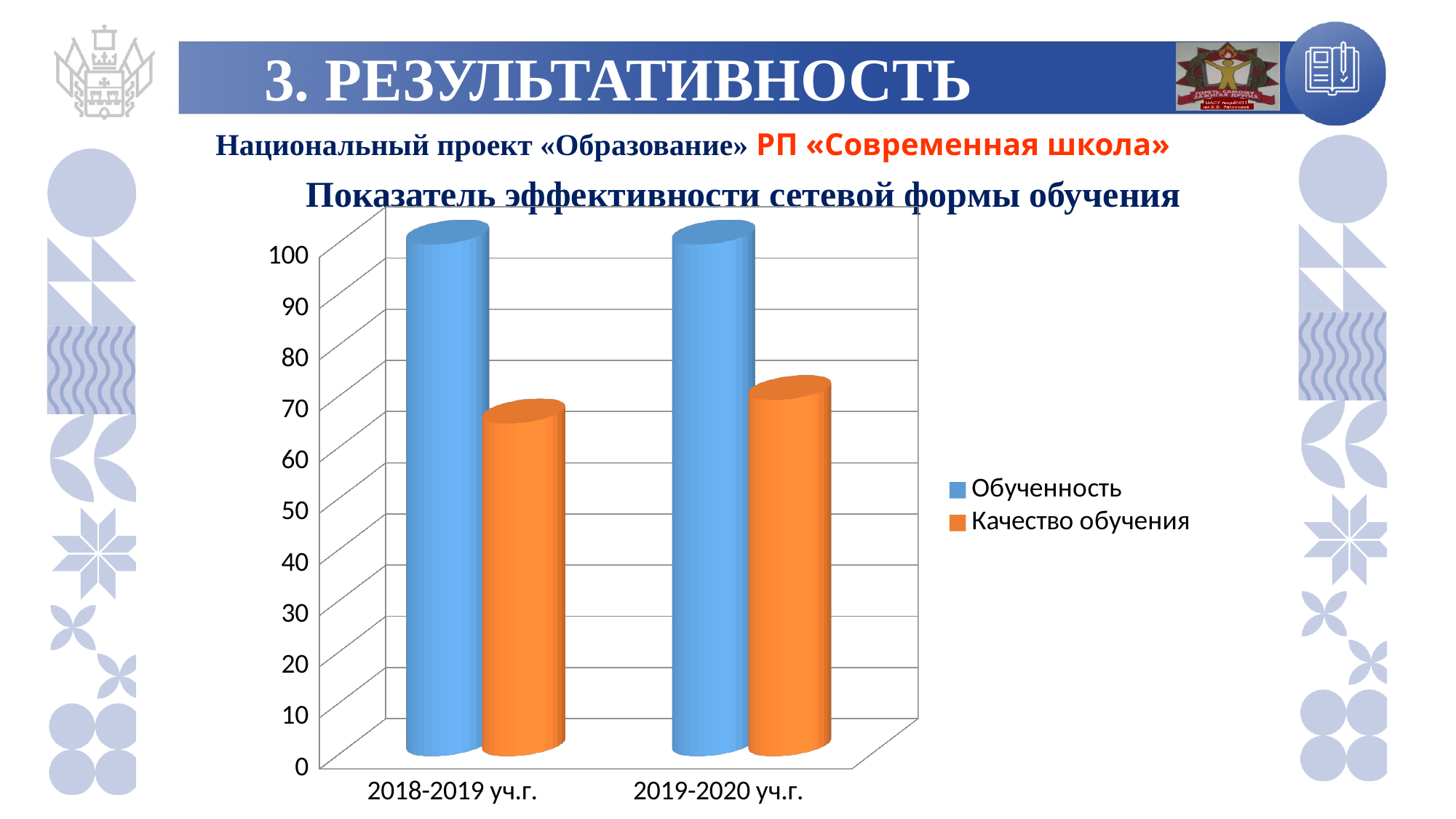
In 2018-2019 уч.г., which is larger: Обученность or Качество обучения? Обученность How many categories are shown on the x axis of the chart? 2 What kind of chart is shown on the slide? Bar chart Is the value for Качество обучения in 2018-2019 уч.г. greater or less than 50? greater Which bar in the chart is the lowest? Качество обучения in 2018-2019 уч.г. How many series does the chart legend list? 2 Is the value for Качество обучения in 2018-2019 уч.г. greater or less than 80? less Does Качество обучения rise or fall from 2018-2019 уч.г. to 2019-2020 уч.г.? Rise What is the title of the chart? Показатель эффективности сетевой формы обучения Is the value for Качество обучения in 2019-2020 уч.г. greater or less than 60? greater Which series is shown in orange in the chart? Качество обучения